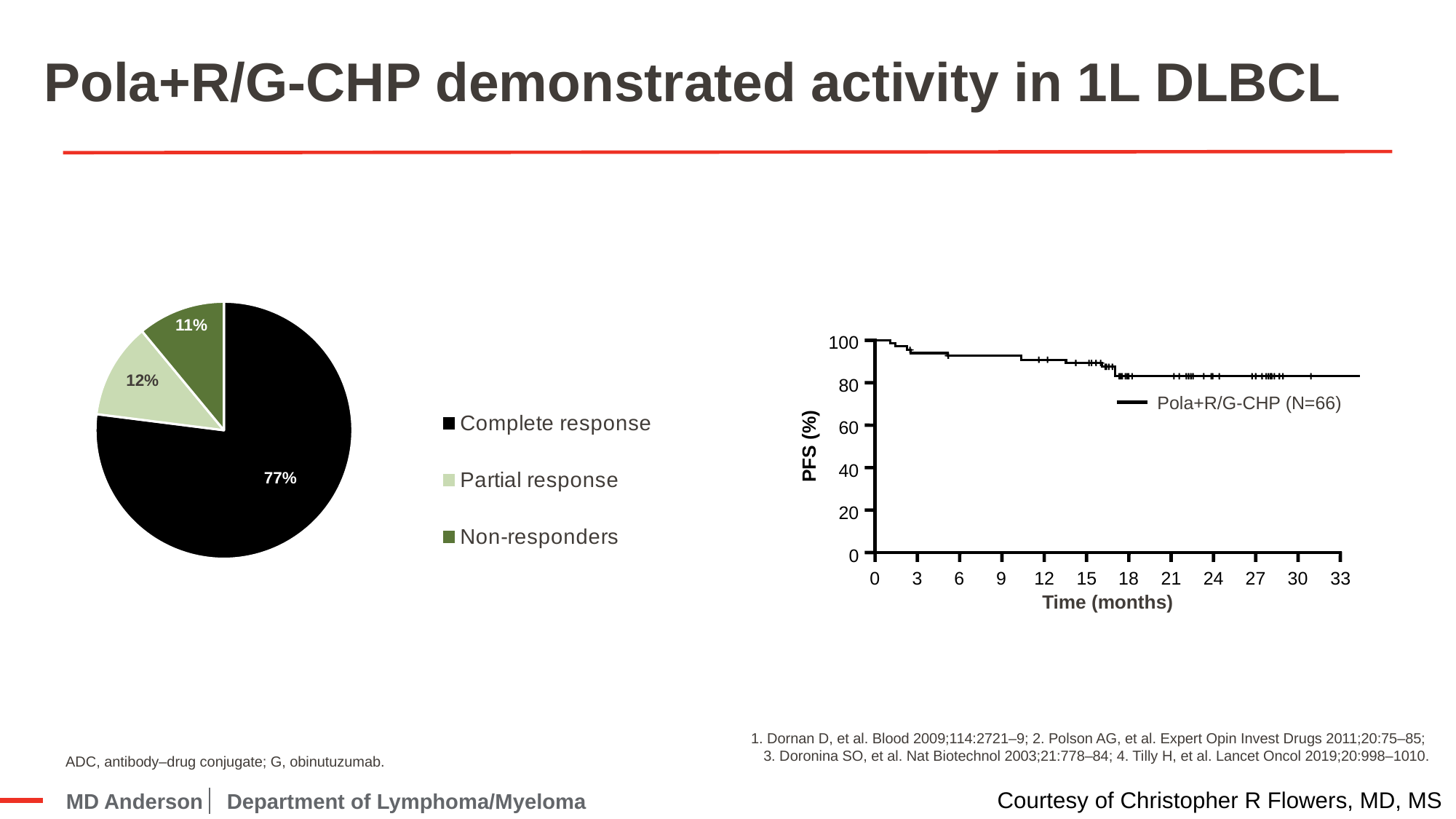
In the pie chart on the left, what is the difference in percentage points between Complete response and Partial response? 65 In the PFS chart on the right, how many series does the legend list? 1 In the pie chart on the left, how many categories are shown? 3 In the pie chart on the left, which category has the largest slice? Complete response In the PFS chart on the right, what is the label of the x axis? Time (months) What type of chart is shown on the right of the slide? Line chart In the PFS chart on the right, is the PFS value at 30 months greater or less than 60? greater In the pie chart on the left, what percentage is labelled for Partial response? 12% In the pie chart on the left, what percentage of patients were non-responders? 11% What type of chart is shown on the left of the slide? Pie chart In the pie chart on the left, which category has the smallest slice? Non-responders In the pie chart on the left, what share of patients had a complete response? 77%